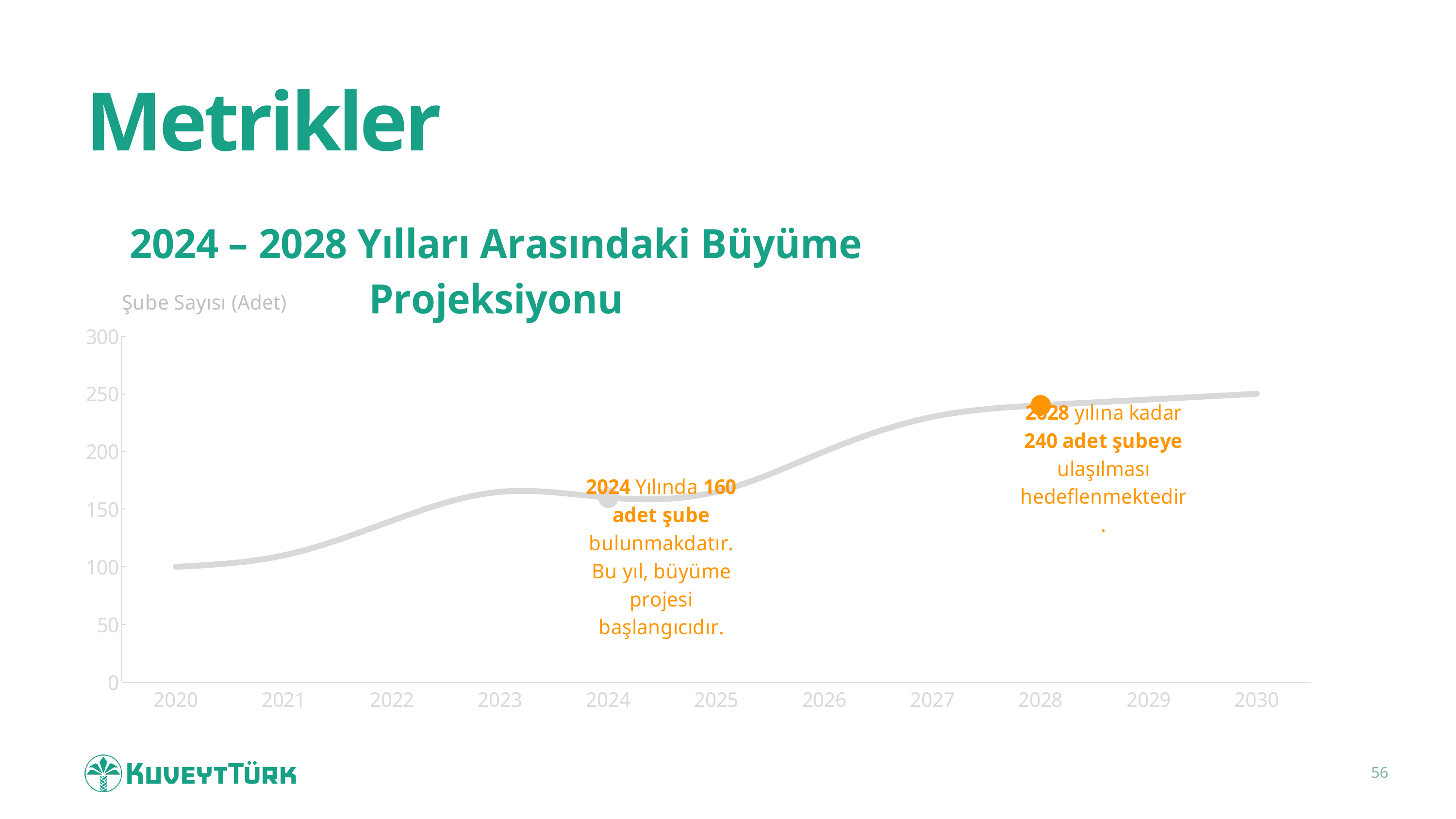
How many branches are targeted by 2028 according to the chart annotation? 240 How many branches (şube) are there in 2024 according to the chart annotation? 160 Is the value for 2030 greater or less than 200? greater What is the label of the vertical axis? Şube Sayısı (Adet) What is the difference between the targeted number of branches in 2028 and the number in 2024? 80 How many years are shown on the x axis? 11 Is the value for 2020 greater or less than 150? less Which year has the lowest number of branches on the chart? 2020 What kind of chart is shown on the slide? line chart Does the number of branches generally rise or fall from 2020 to 2030? rise What is the title of the chart? 2024 – 2028 Yılları Arasındaki Büyüme Projeksiyonu Which year has the larger number of branches, 2024 or 2028? 2028